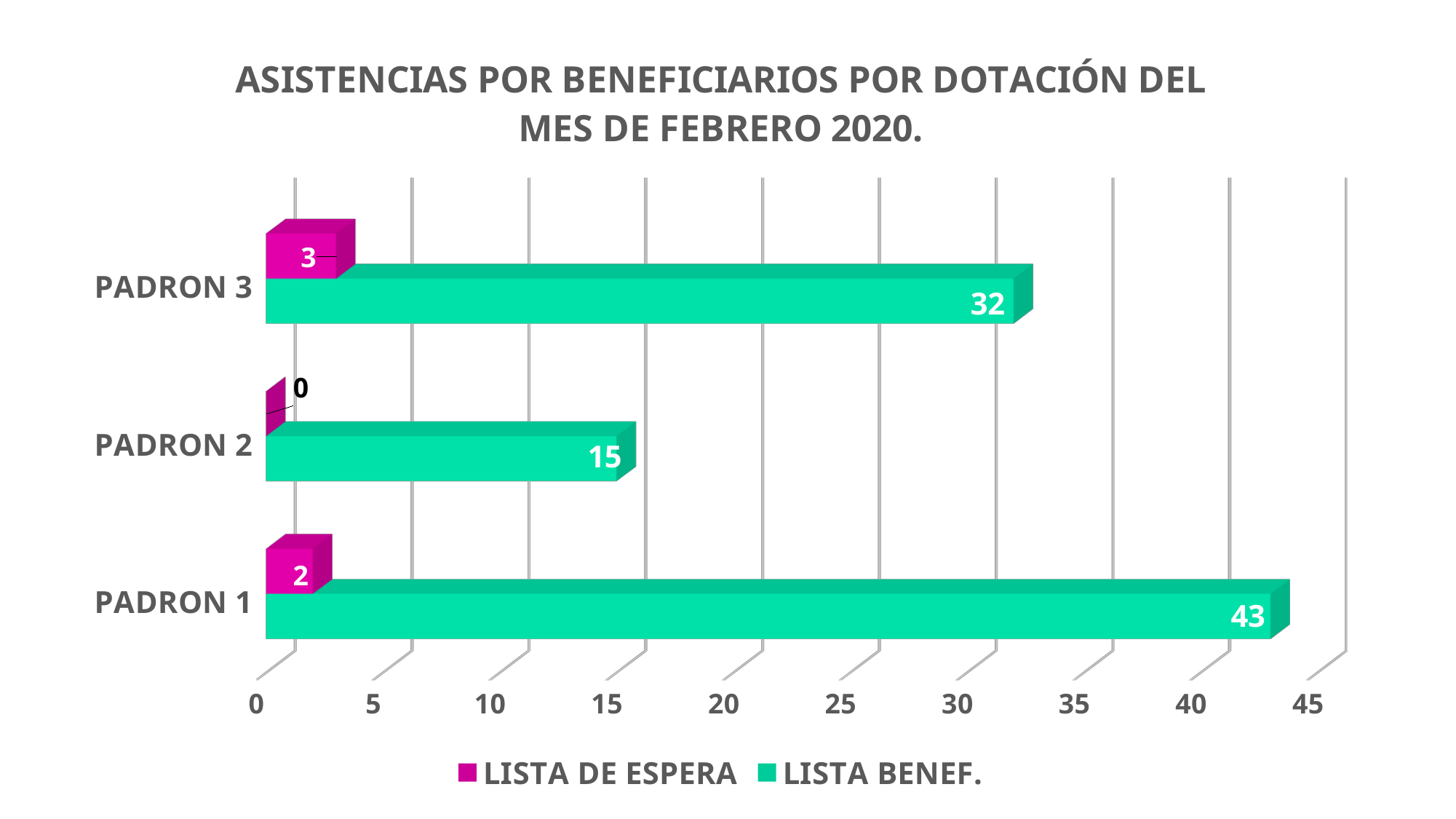
Which is larger, the LISTA BENEF. value for PADRON 2 or for PADRON 3? PADRON 3 Which category has the highest LISTA BENEF. value? PADRON 1 What is the difference between the LISTA BENEF. values for PADRON 1 and PADRON 3? 11 How many series does the legend list? 2 How many categories are shown on the chart? 3 What is the LISTA DE ESPERA value for PADRON 3? 3 Which colour represents the LISTA DE ESPERA series? magenta What is the LISTA BENEF. value for PADRON 1? 43 What kind of chart is shown on the slide? bar chart What is the LISTA BENEF. value for PADRON 2? 15 Which category has the lowest LISTA DE ESPERA value? PADRON 2 Is the LISTA BENEF. value for PADRON 3 greater or less than 30? greater